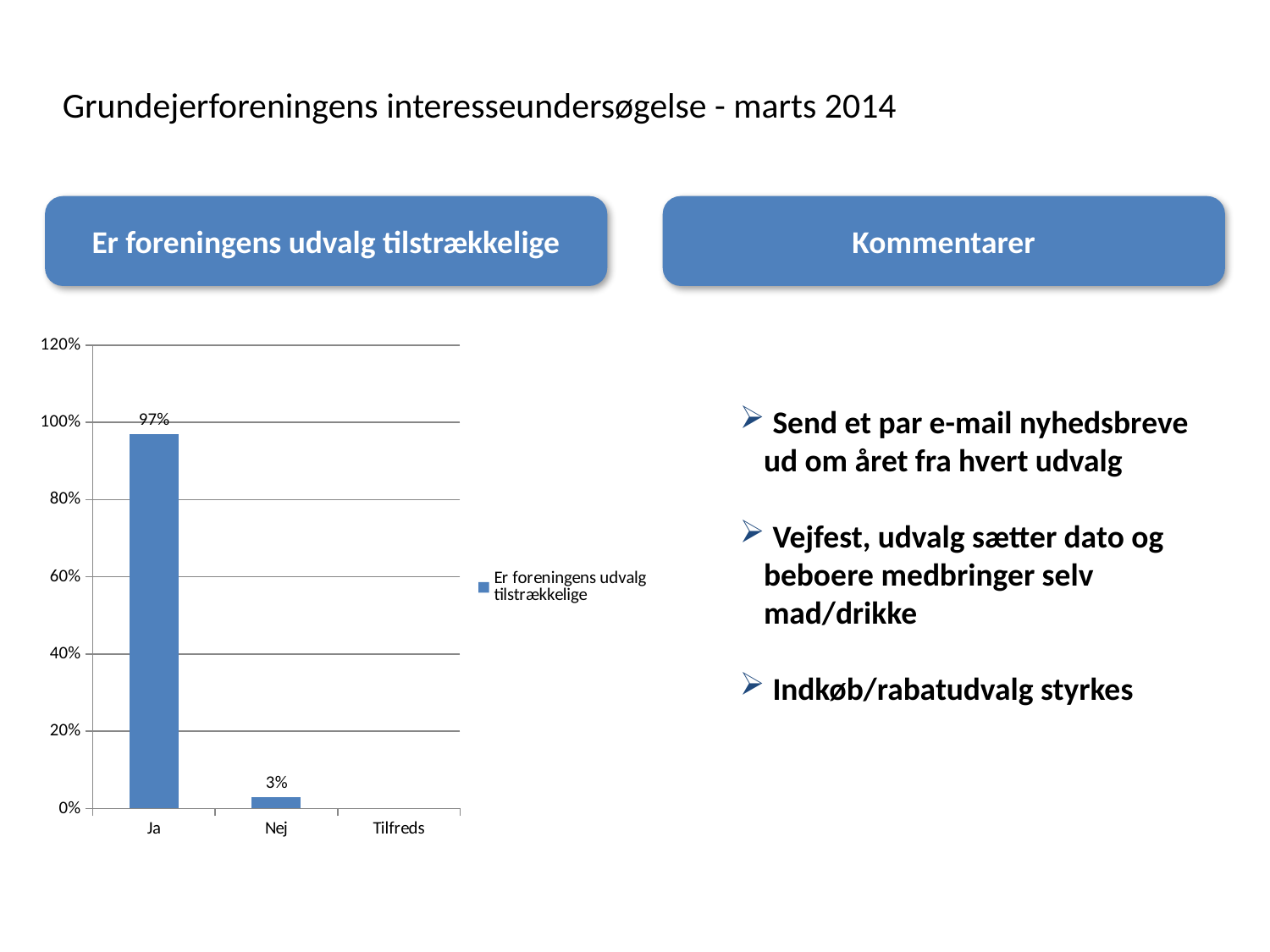
What is the value for Nej? 3% Which category has the highest value? Ja How many series does the legend list? 1 Which is larger, the value for Ja or the value for Nej? Ja Is the value for Ja greater or less than 80%? greater What is the highest value shown on the y axis? 120% What kind of chart is shown? bar chart What is the value for Ja? 97% What is the series name shown in the legend? Er foreningens udvalg tilstrækkelige Is the value for Nej greater or less than 20%? less How many categories are shown on the x axis? 3 What is the difference between the values for Ja and Nej? 94%